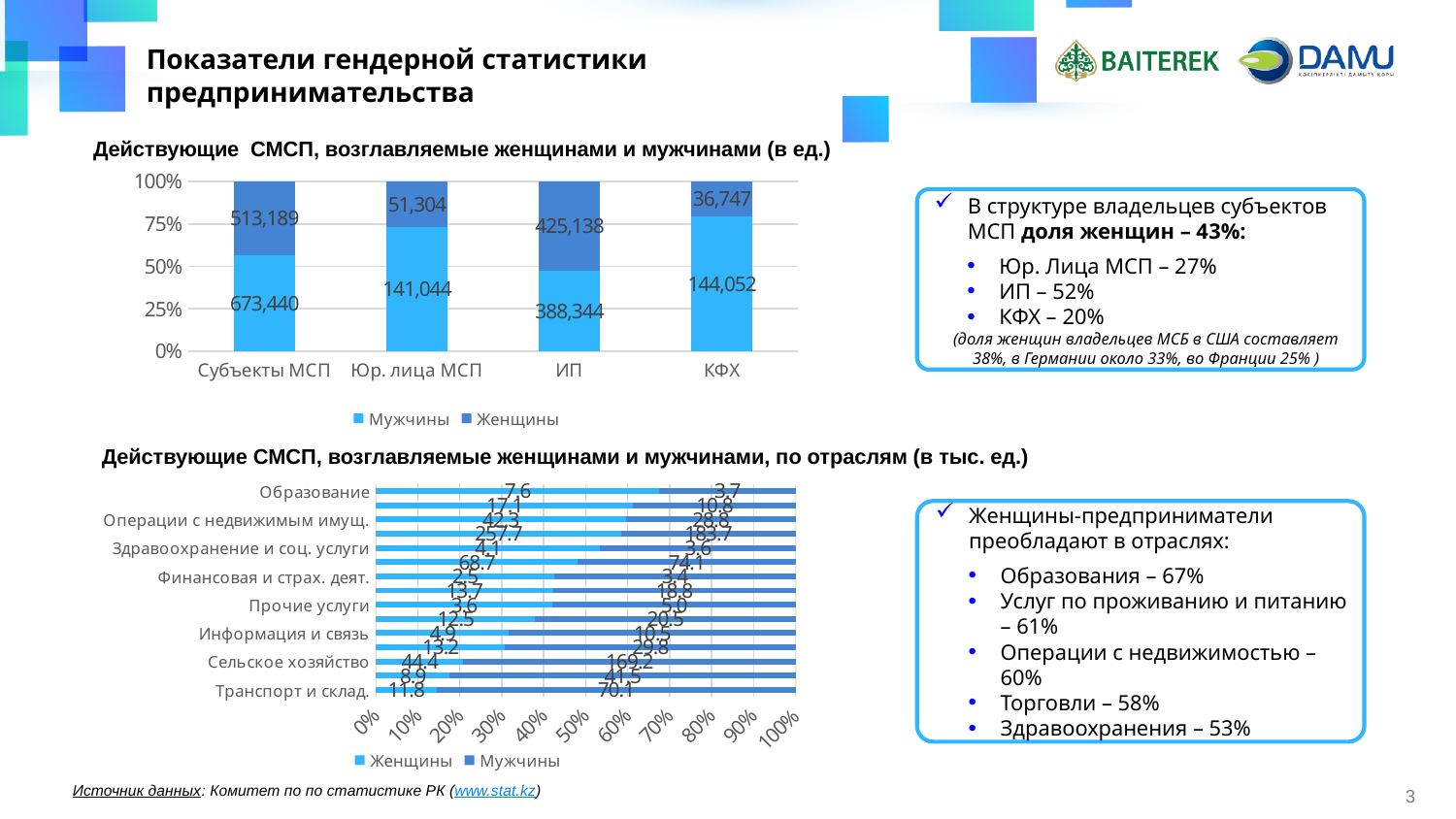
In the top chart 'Действующие СМСП, возглавляемые женщинами и мужчинами (в ед.)', what is the value for Мужчины in the category Субъекты МСП? 673,440 In the top chart 'Действующие СМСП, возглавляемые женщинами и мужчинами (в ед.)', which is larger in the category ИП: Мужчины or Женщины? Женщины How many series does the legend of the top chart 'Действующие СМСП, возглавляемые женщинами и мужчинами (в ед.)' list? 2 What kind of chart is the bottom chart 'Действующие СМСП, возглавляемые женщинами и мужчинами, по отраслям (в тыс. ед.)'? Stacked bar chart In the bottom chart 'Действующие СМСП, возглавляемые женщинами и мужчинами, по отраслям (в тыс. ед.)', what is the value for Женщины in the category Образование? 7.6 In the top chart 'Действующие СМСП, возглавляемые женщинами и мужчинами (в ед.)', which category has the lowest value for Женщины? КФХ In the top chart 'Действующие СМСП, возглавляемые женщинами и мужчинами (в ед.)', which category has the highest value for Мужчины? Субъекты МСП In the top chart 'Действующие СМСП, возглавляемые женщинами и мужчинами (в ед.)', what is the value for Женщины in the category КФХ? 36,747 How many categories are shown on the x axis of the top chart 'Действующие СМСП, возглавляемые женщинами и мужчинами (в ед.)'? 4 In the top chart 'Действующие СМСП, возглавляемые женщинами и мужчинами (в ед.)', what is the difference between Мужчины and Женщины in the category Субъекты МСП? 160,251 In the top chart 'Действующие СМСП, возглавляемые женщинами и мужчинами (в ед.)', what is the total of the stacked bar for Юр. лица МСП? 192,348 In the top chart 'Действующие СМСП, возглавляемые женщинами и мужчинами (в ед.)', what is the value for Женщины in the category ИП? 425,138